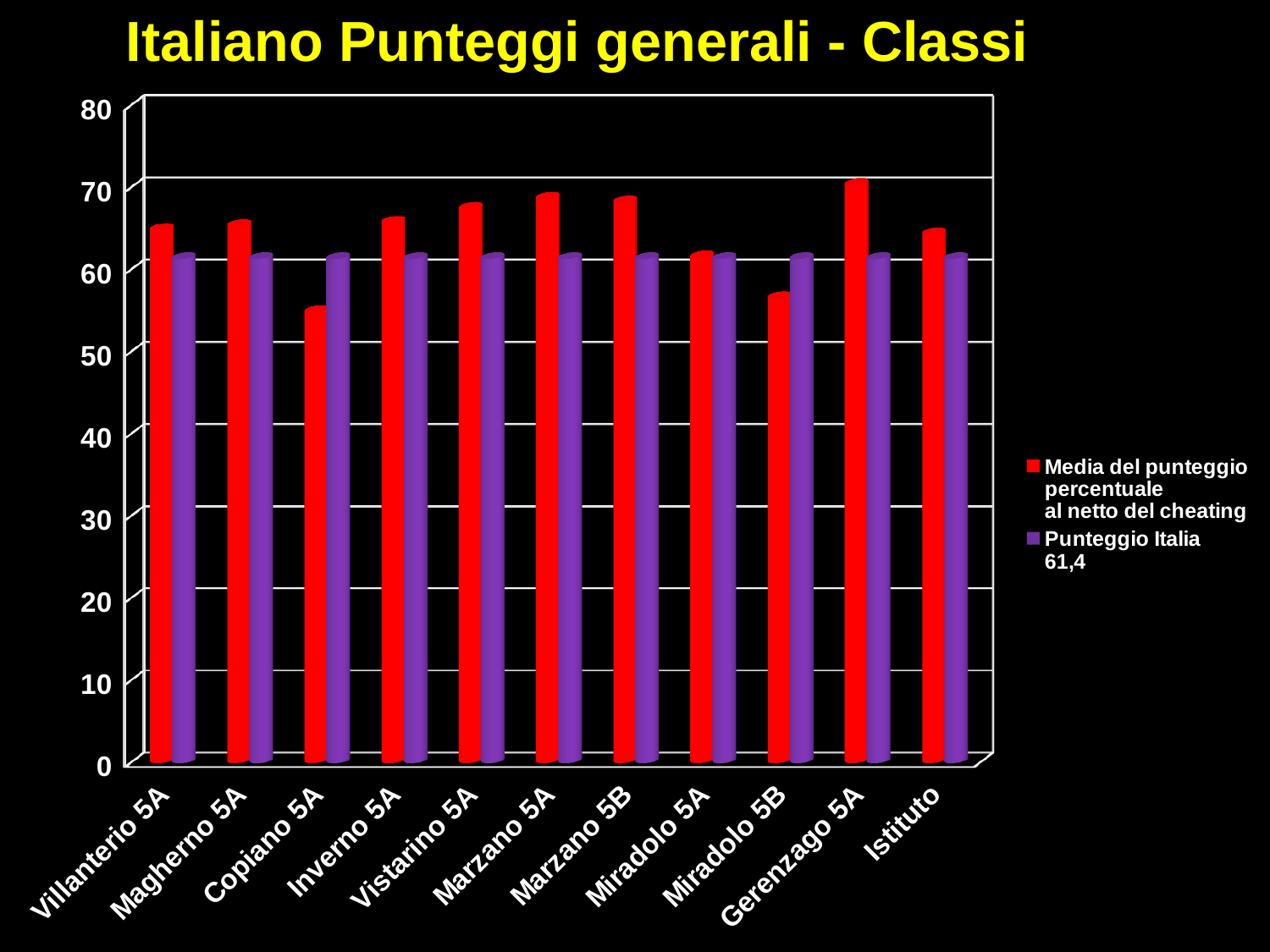
How many series does the legend list? 2 How many categories are shown on the x axis? 11 What is the value of the Punteggio Italia series shown in the legend? 61,4 Which has the larger value for Media del punteggio percentuale al netto del cheating, Vistarino 5A or Miradolo 5A? Vistarino 5A Which category has the lowest value for Media del punteggio percentuale al netto del cheating? Copiano 5A What is the title of the chart? Italiano Punteggi generali - Classi What kind of chart is shown on the slide? bar chart Which has the larger value for Media del punteggio percentuale al netto del cheating, Marzano 5A or Copiano 5A? Marzano 5A Is the value for Miradolo 5B in the Media del punteggio percentuale al netto del cheating series greater or less than 60? less Is the value for Copiano 5A in the Media del punteggio percentuale al netto del cheating series greater or less than 60? less Which category has the highest value for Media del punteggio percentuale al netto del cheating? Gerenzago 5A Is the value for Marzano 5A in the Media del punteggio percentuale al netto del cheating series greater or less than 60? greater